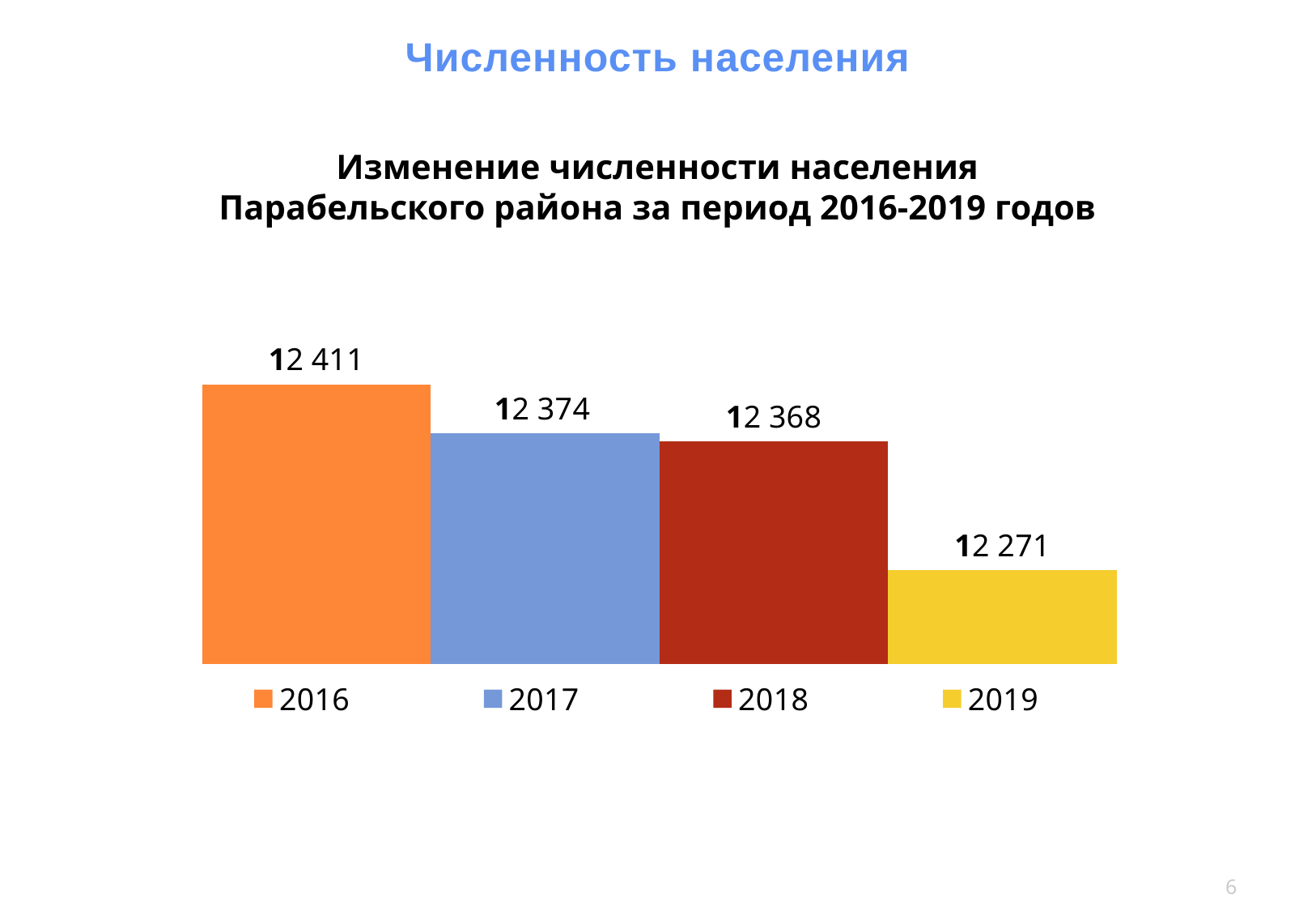
What is the difference between the population values for 2016 and 2019? 140 Which year has the highest population value? 2016 What is the population value shown for 2019? 12 271 What is the population value shown for 2018? 12 368 Which year has the lowest population value? 2019 Do the population values rise or fall from 2016 to 2019? Fall What is the difference between the population values for 2017 and 2018? 6 What is the population value shown for 2016? 12 411 What kind of chart is shown on the slide? Bar chart What is the population value shown for 2017? 12 374 Which is larger, the population value for 2016 or for 2019? 2016 How many bars are plotted in the chart? 4